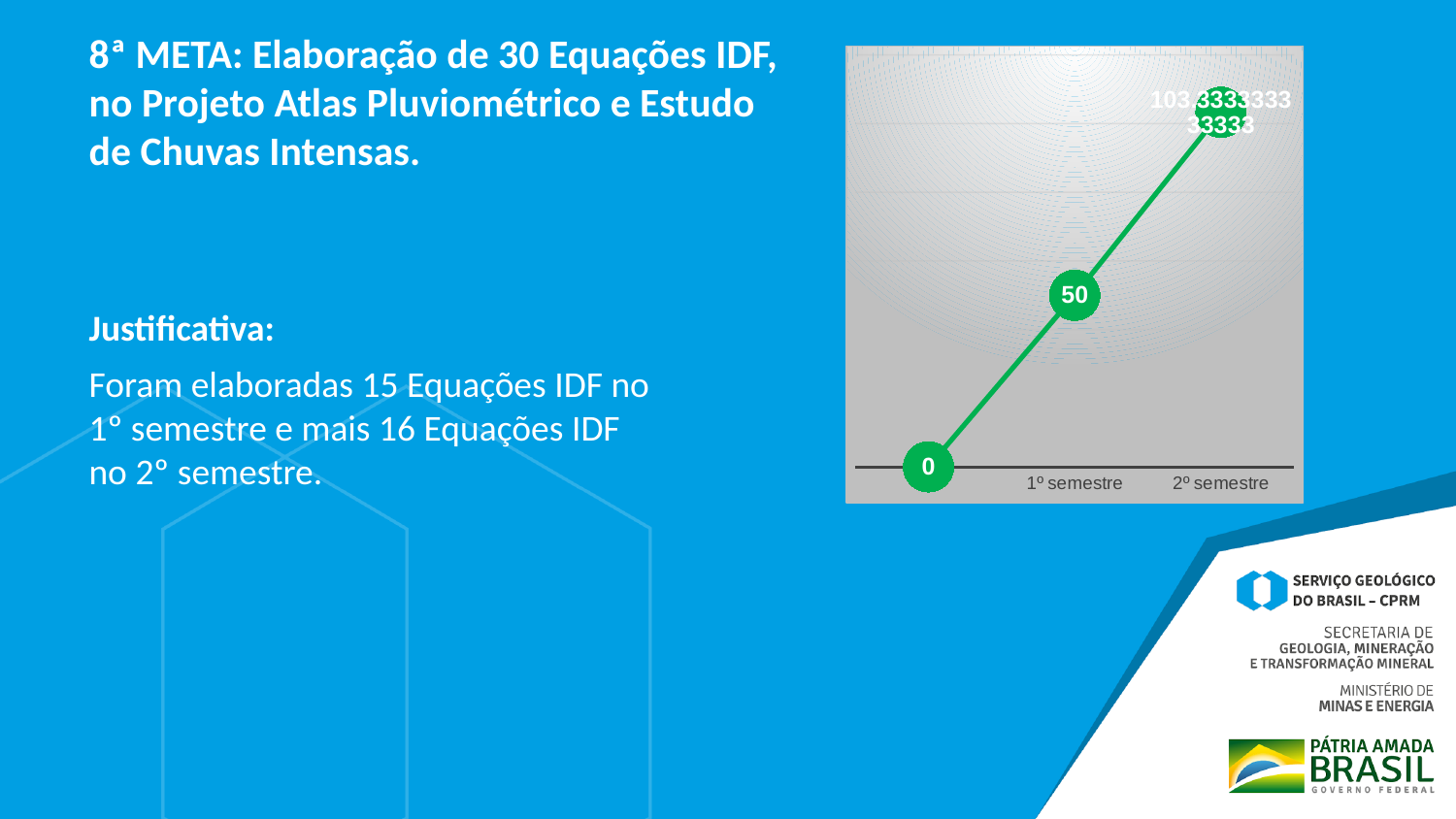
Which x-axis category has the highest value, 1º semestre or 2º semestre? 2º semestre What colour is the plotted line? green Do the values rise or fall from left to right along the x axis? rise What is the value shown on the leftmost data point of the line? 0 What is the value plotted for 1º semestre? 50 How many data points are plotted on the line? 3 Is the value for 2º semestre larger or smaller than the value for 1º semestre? larger What is the difference between the value for 1º semestre and the leftmost point labelled 0? 50 How many category labels are shown on the x axis? 2 What kind of chart is shown on the slide? line chart